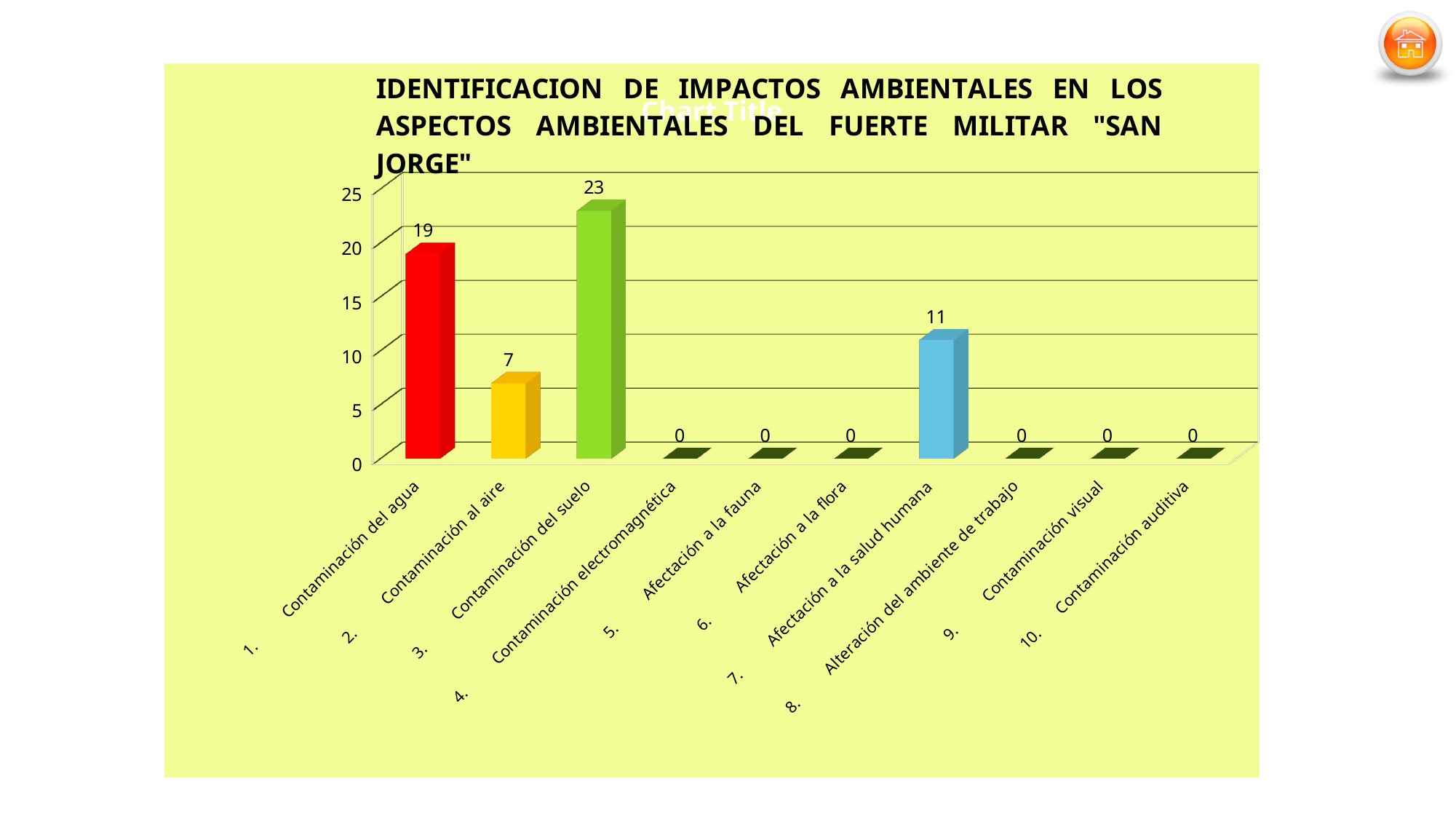
What is the difference between the values for Afectación a la salud humana and Contaminación al aire? 4 What is the value for Contaminación visual? 0 What is the difference between the values for Contaminación del suelo and Contaminación del agua? 4 What is the value for Contaminación al aire? 7 How many categories have a value of 0? 6 Which category has the highest value? Contaminación del suelo What kind of chart is shown on the slide? Bar chart What is the value for Contaminación del suelo? 23 What is the value for Contaminación del agua? 19 Which is larger, the value for Contaminación del agua or the value for Afectación a la salud humana? Contaminación del agua How many categories are shown on the x axis? 10 What is the value for Afectación a la salud humana? 11